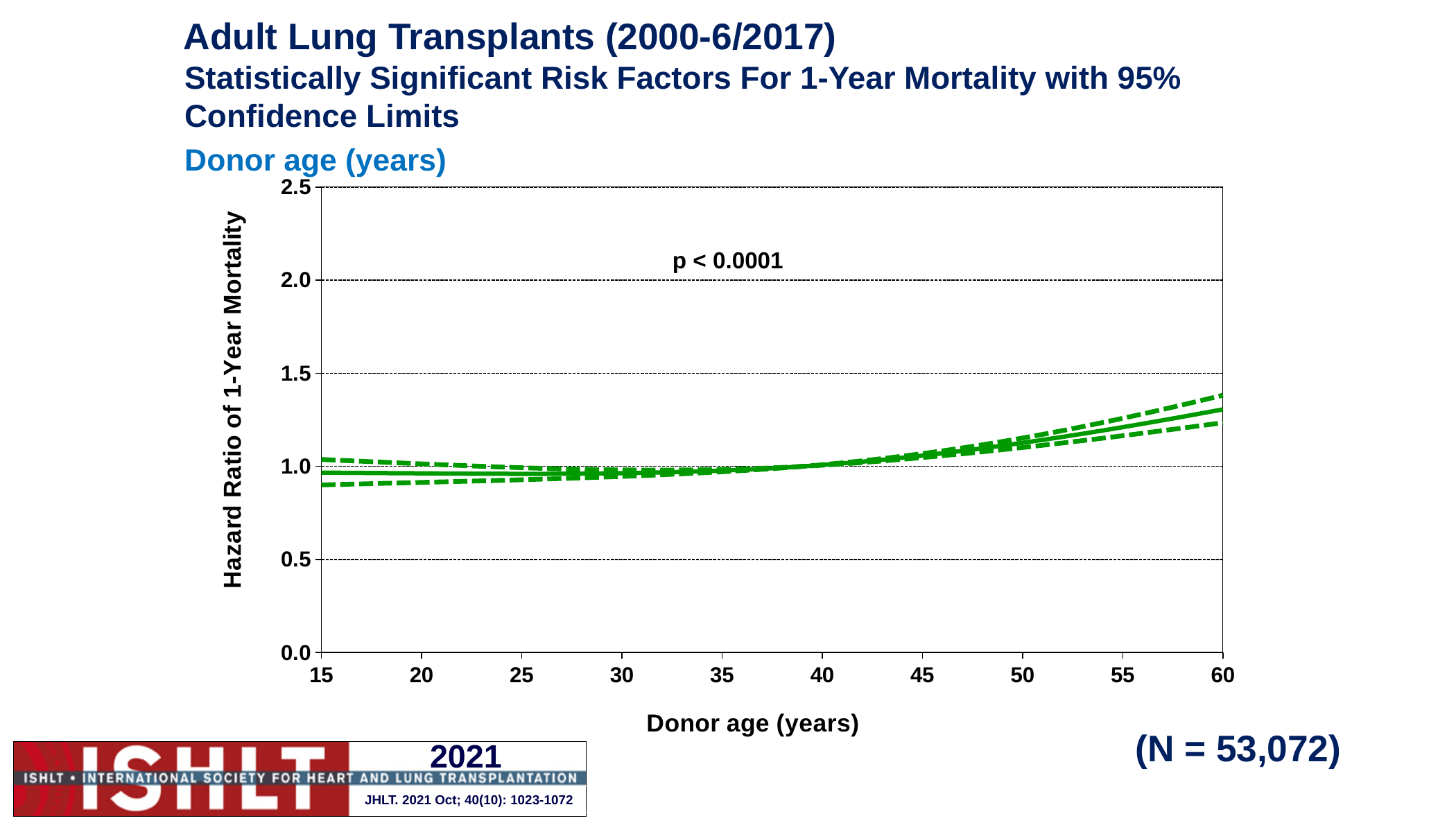
Which donor age shown on the x axis has the highest hazard ratio of 1-year mortality? 60 What kind of chart is shown on the slide? line chart Is the hazard ratio of 1-year mortality at donor age 60 greater or less than 1.5? less Does the hazard ratio of 1-year mortality rise or fall as donor age increases from 40 to 60 years? rises Is the hazard ratio of 1-year mortality higher at donor age 60 or at donor age 35? 60 What sample size (N) is shown on the slide? N = 53,072 Is the hazard ratio of 1-year mortality at donor age 30 greater or less than 0.5? greater How many lines (solid and dashed) are plotted on the chart? 3 Is the hazard ratio of 1-year mortality at donor age 60 greater or less than 1.0? greater What p-value is printed on the chart? p < 0.0001